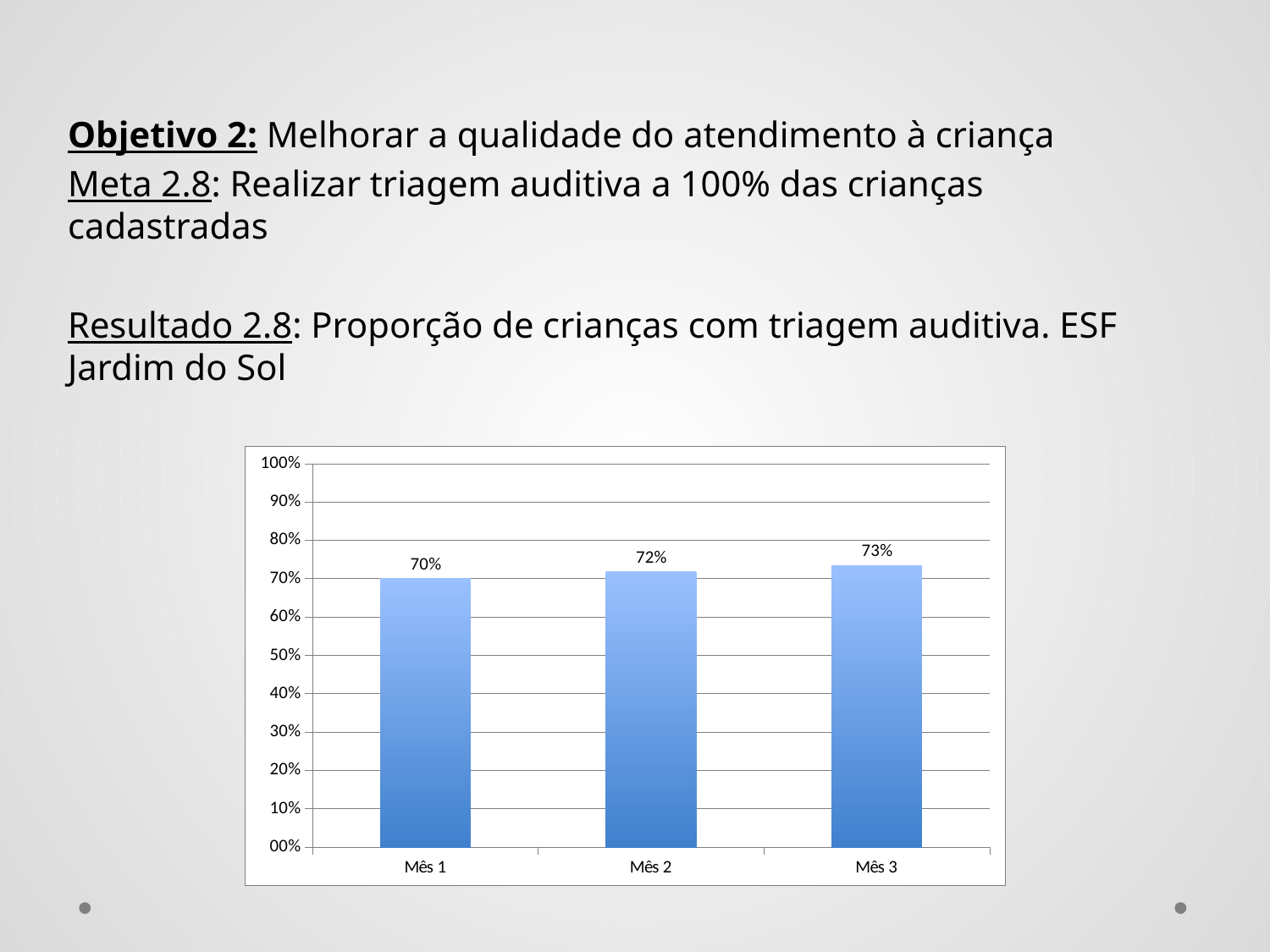
What is the difference between the values for Mês 2 and Mês 1? 2% Do the values rise or fall from Mês 1 to Mês 3? rise Which month has the lowest value? Mês 1 What is the value for Mês 1? 70% What is the value for Mês 3? 73% What kind of chart is shown on the slide? bar chart Which month has the highest value? Mês 3 What is the value for Mês 2? 72% How many months are shown on the x axis? 3 Is the value for Mês 2 greater or less than 80%? less What is the difference between the values for Mês 3 and Mês 1? 3% Which is larger, the value for Mês 1 or the value for Mês 3? Mês 3